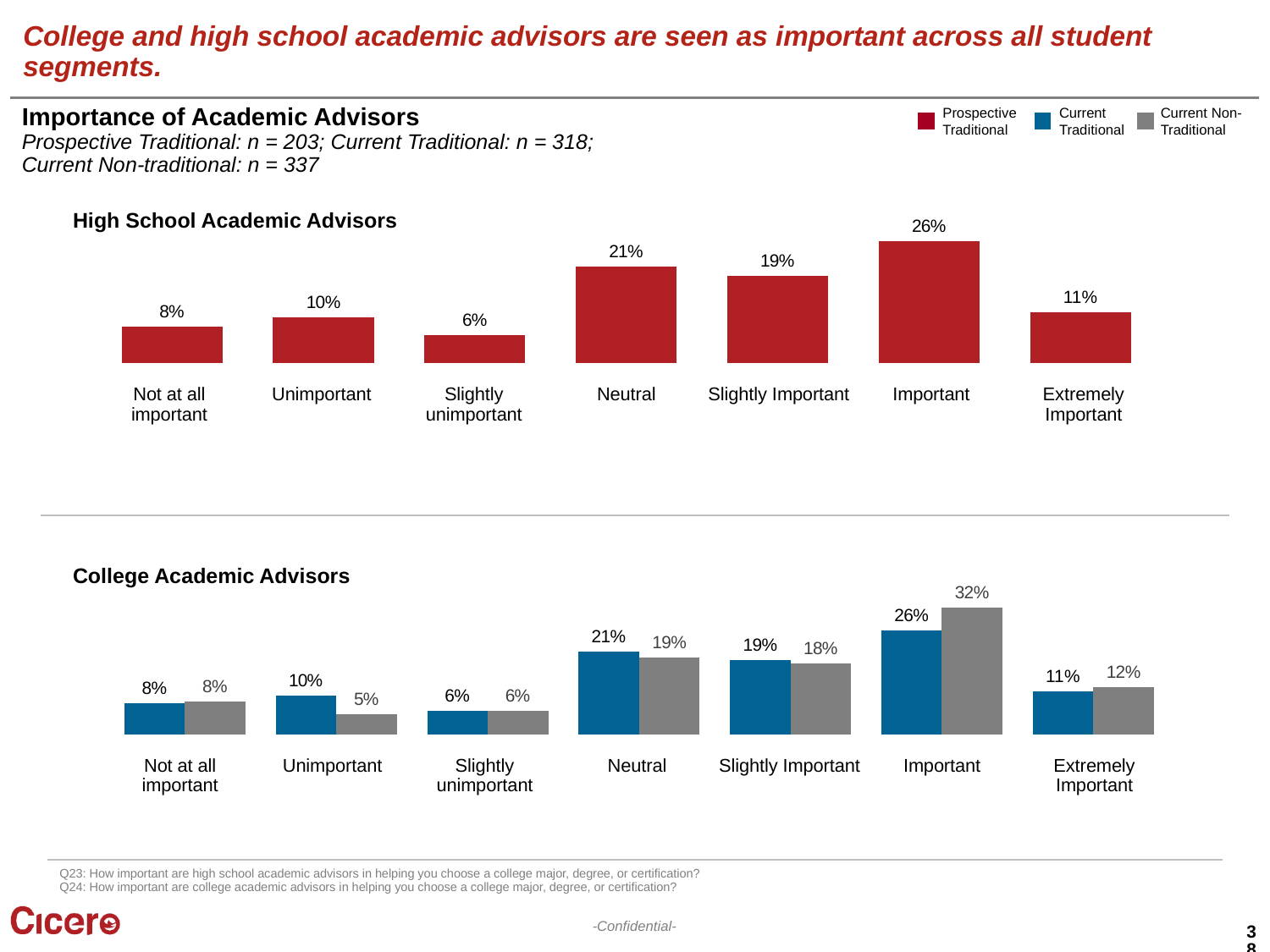
In the High School Academic Advisors chart, what percentage of respondents rated them as Important? 26% In the College Academic Advisors chart, which category has the highest Current Non-Traditional value? Important In the College Academic Advisors chart, which is larger for Unimportant: Current Traditional or Current Non-Traditional? Current Traditional In the High School Academic Advisors chart, how many categories are shown on the x axis? 7 How many series does the legend at the top of the slide list? 3 In the High School Academic Advisors chart, which category has the lowest value? Slightly unimportant What type of chart is the High School Academic Advisors chart? Bar chart In the College Academic Advisors chart, what is the Current Traditional value for Neutral? 21% In the College Academic Advisors chart, what is the Current Non-Traditional value for Important? 32% In the High School Academic Advisors chart, what is the difference between the Neutral and Slightly Important values? 2% In the College Academic Advisors chart, what is the difference between the Current Non-Traditional and Current Traditional values for Important? 6% In the College Academic Advisors chart, how many series are plotted? 2